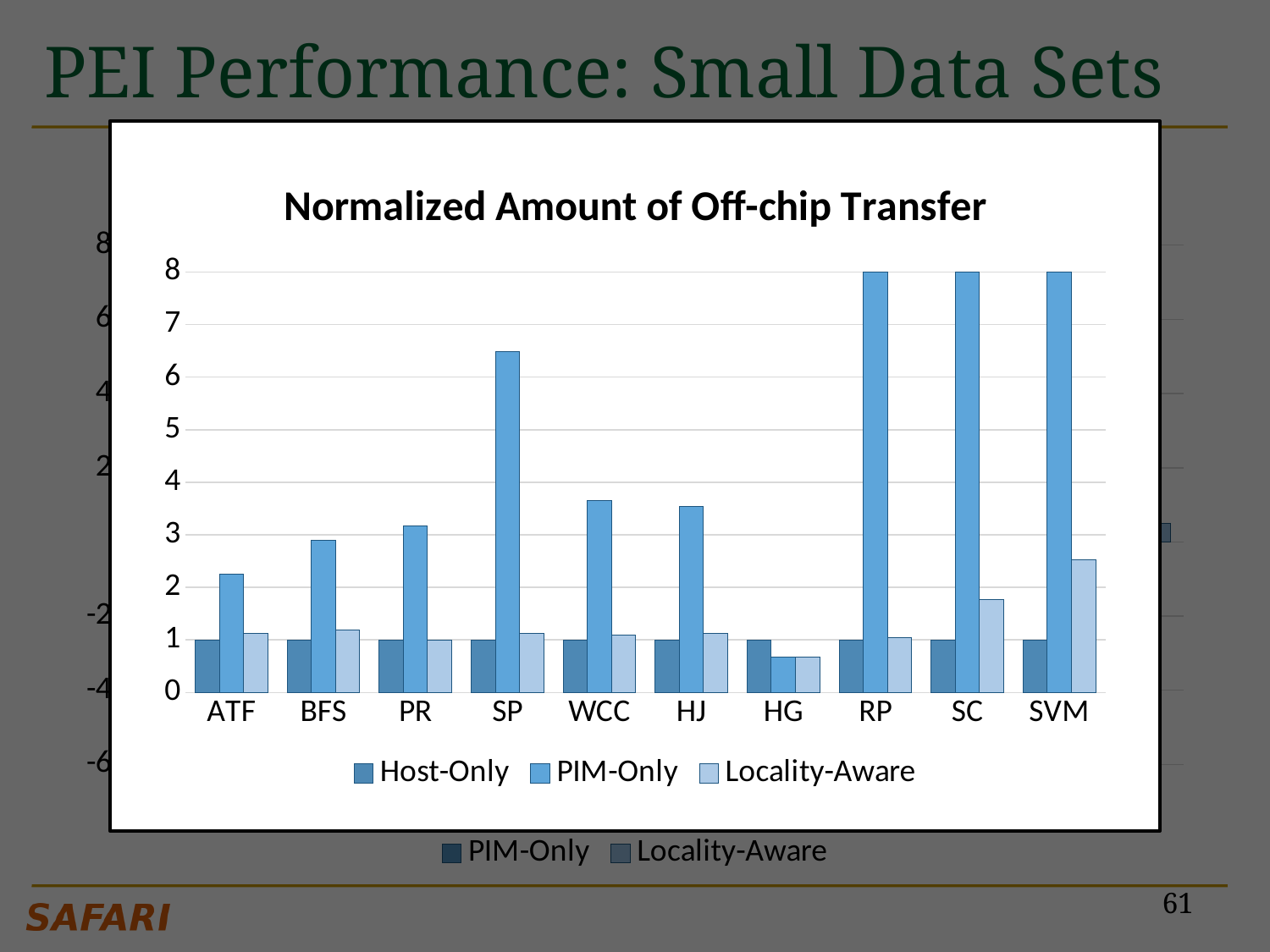
What kind of chart is shown on the slide? bar chart Is the PIM-Only value for HG greater or less than 1? less What is the title of the chart? Normalized Amount of Off-chip Transfer Which is larger, the Locality-Aware value for SC or the Locality-Aware value for ATF? SC How many categories are shown on the x axis of the 'Normalized Amount of Off-chip Transfer' chart? 10 Which is larger, the PIM-Only value for SP or the PIM-Only value for WCC? SP Is the PIM-Only value for SP greater or less than 6? greater Is the PIM-Only value for BFS greater or less than 2? greater What are the three series listed in the chart legend? Host-Only, PIM-Only, Locality-Aware Which category has the lowest PIM-Only value? HG How many series does the legend of the 'Normalized Amount of Off-chip Transfer' chart list? 3